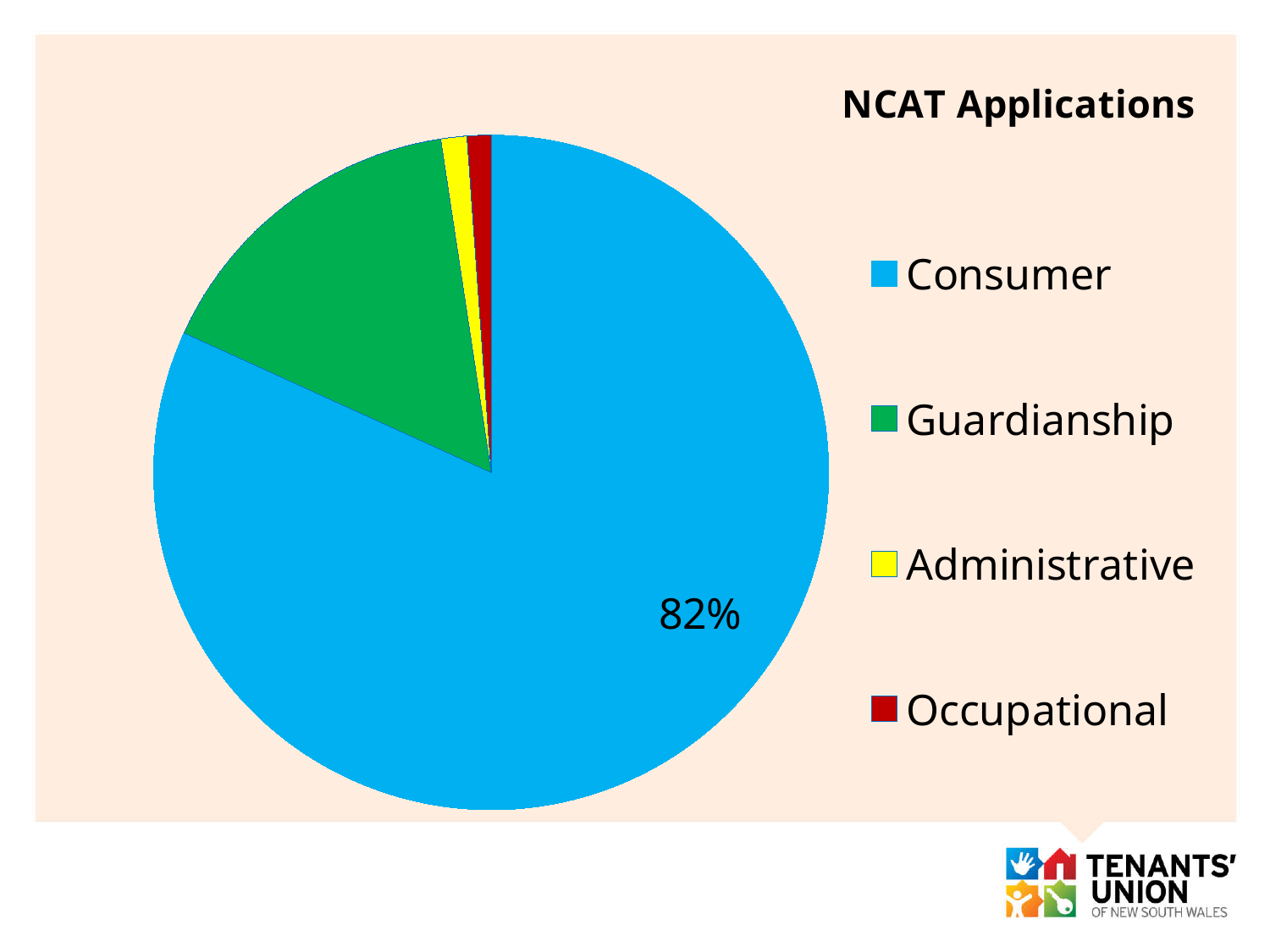
Which category is the second largest slice of the pie? Guardianship What is the title of the chart? NCAT Applications Which is larger, the Administrative slice or the Occupational slice? Administrative What type of chart is shown on the slide? pie chart Which category has the smallest slice of the pie? Occupational Which category has the largest slice of the pie? Consumer Which colour represents Guardianship in the chart? green Which is larger, the Consumer slice or the Guardianship slice? Consumer What share of NCAT Applications is Consumer? 82% Which is larger, the Guardianship slice or the Administrative slice? Guardianship How many categories does the legend list? 4